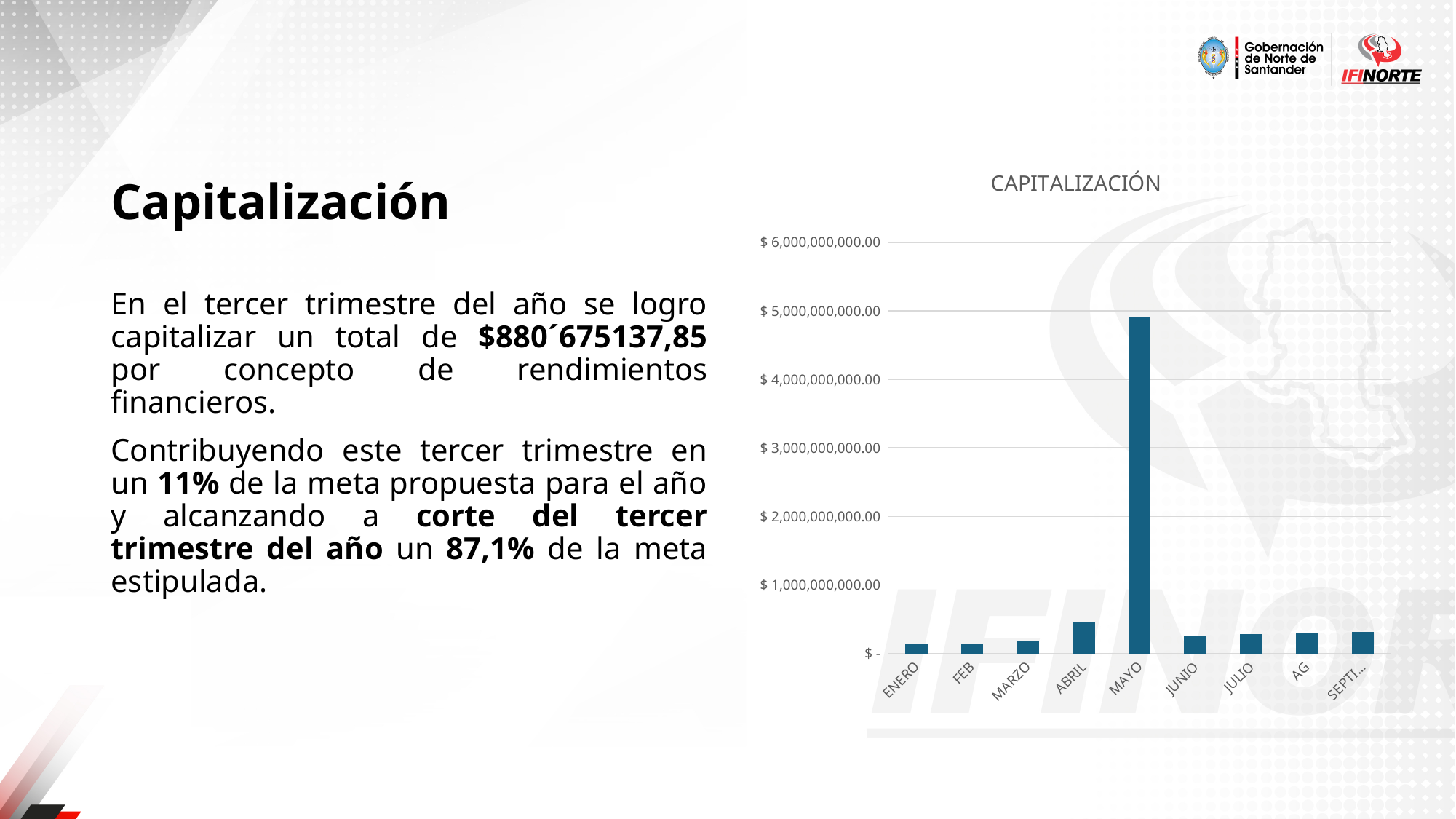
Which is larger, the value for JUNIO or the value for ENERO? JUNIO Which is larger, the value for ABRIL or the value for MARZO? ABRIL Is the value for ABRIL greater or less than $ 1,000,000,000.00? less Which is larger, the value for MAYO or the value for JUNIO? MAYO What is the title of the chart? CAPITALIZACIÓN Is the value for MAYO greater or less than $ 4,000,000,000.00? greater Which month has the highest capitalización value? MAYO What kind of chart is shown on the slide? Bar chart What is the highest value shown on the vertical axis of the chart? $ 6,000,000,000.00 Is the value for MAYO greater or less than $ 5,000,000,000.00? less How many bars (months) are plotted in the chart? 9